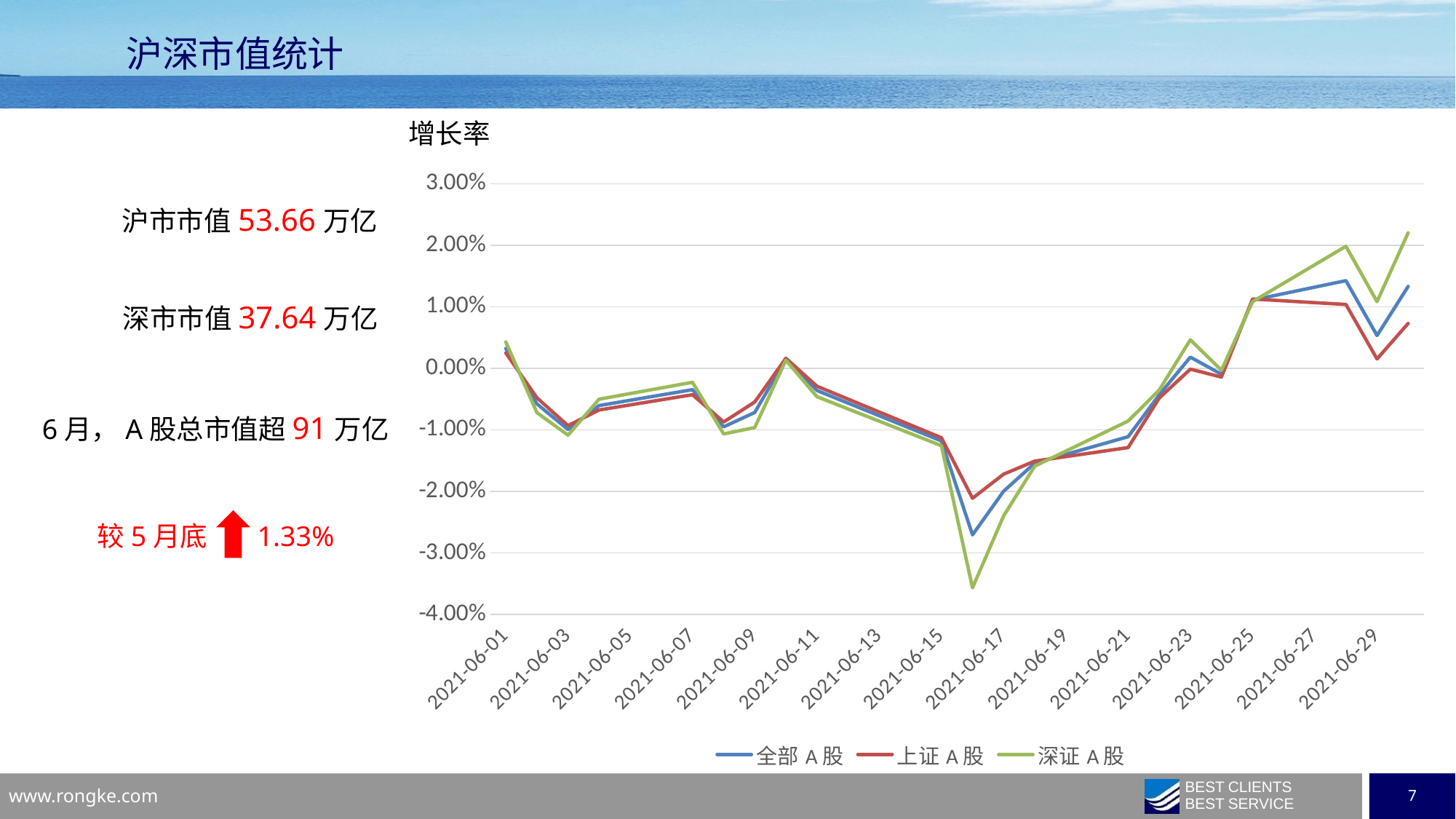
Which series are listed in the chart's legend? 全部A股, 上证A股, 深证A股 On 2021-06-17, which series has the lower value, 深证A股 or 上证A股? 深证A股 Is the value for 上证A股 on 2021-06-17 greater or less than -1.00%? less What kind of chart is shown on the slide? line chart How many date labels are shown on the x axis? 15 From 2021-06-17 to 2021-06-27, does the 全部A股 line rise or fall overall? rise How many series does the chart's legend list? 3 Is the value for 深证A股 on 2021-06-17 greater or less than -3.00%? greater What is the title of the chart? 增长率 Which series reaches the lowest value anywhere on the chart? 深证A股